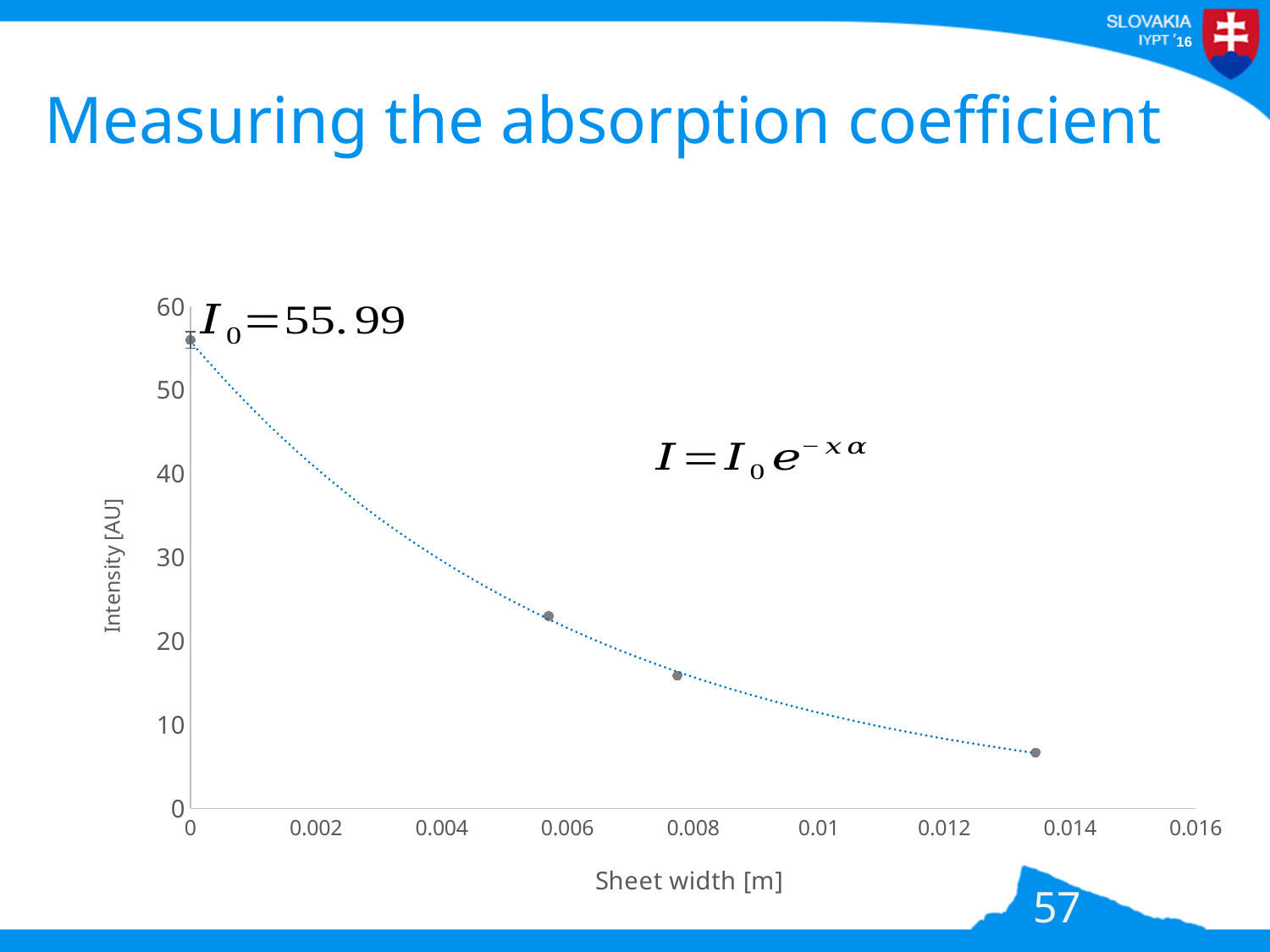
How many data points are plotted on the chart? 4 Do the intensity values rise or fall as sheet width increases along the x axis? Fall Is the intensity of the data point at sheet width 0 greater or less than 50? greater What kind of chart is shown on the slide? Scatter chart with a fitted dotted curve Is the intensity of the data point near sheet width 0.006 m greater or less than 30? less What value of I0 is printed on the chart? 55.99 What is the label of the y axis? Intensity [AU] Is the intensity of the data point near sheet width 0.008 m greater or less than 10? greater What is the label of the x axis? Sheet width [m] Which data point has the highest intensity: the one at sheet width 0 or the one near 0.0134 m? The one at sheet width 0 Which data point has the lowest intensity? The rightmost point, near 0.0134 m